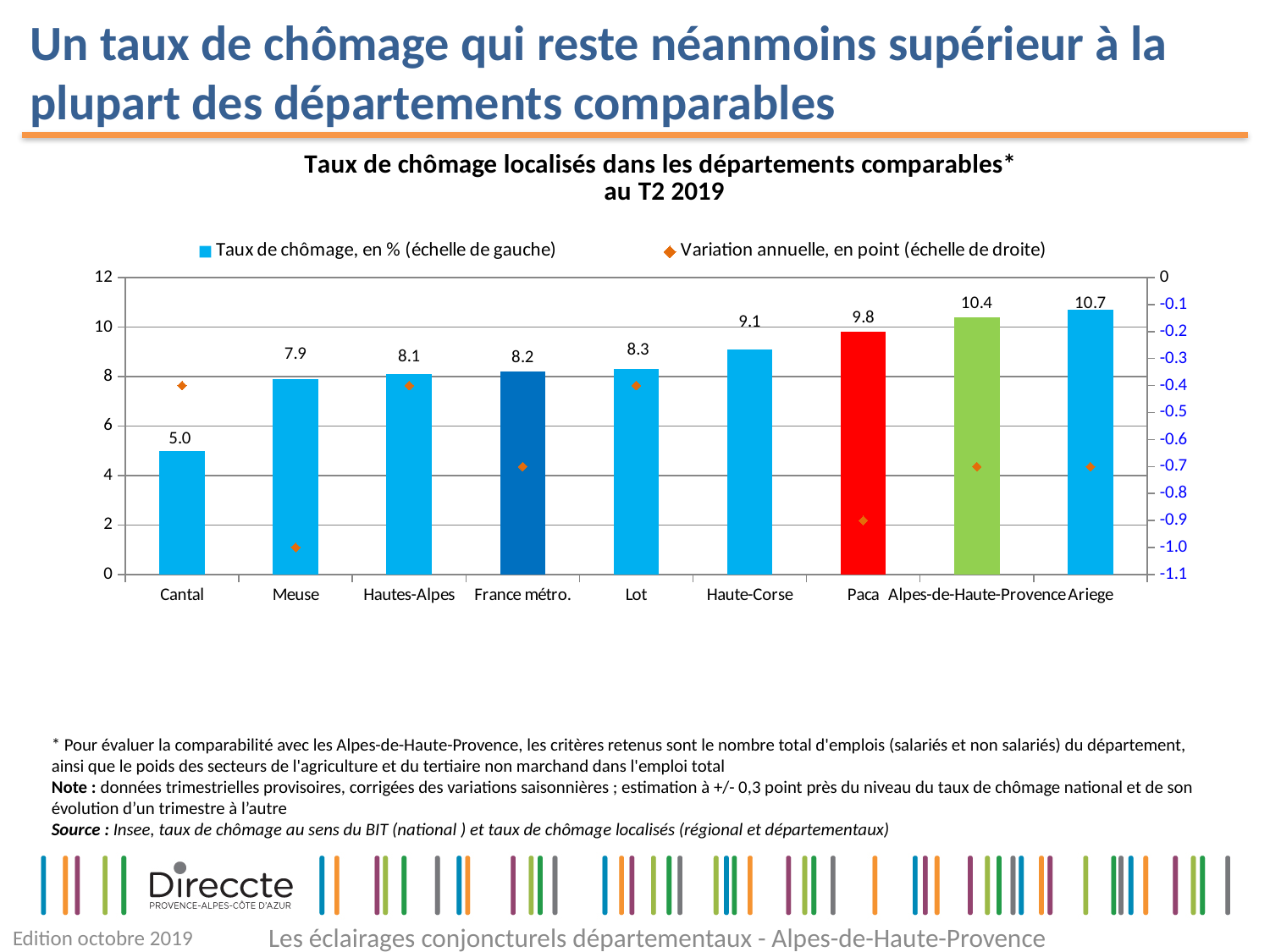
What type of chart is used to show the unemployment rates? Bar chart How many series does the legend list? 2 What is the unemployment rate shown for Alpes-de-Haute-Provence? 10.4 Is the annual variation (variation annuelle) for Meuse greater or less than -0.8 points? less What is the difference between the unemployment rates of Alpes-de-Haute-Provence and Paca? 0.6 What is the difference between the unemployment rates of Ariege and Cantal? 5.7 Which department has the lowest unemployment rate in the chart? Cantal How many departments/categories are shown on the x axis? 9 What is the unemployment rate (taux de chômage) shown for Cantal? 5.0 Which has a higher unemployment rate, Haute-Corse or Lot? Haute-Corse What is the unemployment rate shown for France métro.? 8.2 Which department has the highest unemployment rate in the chart? Ariege